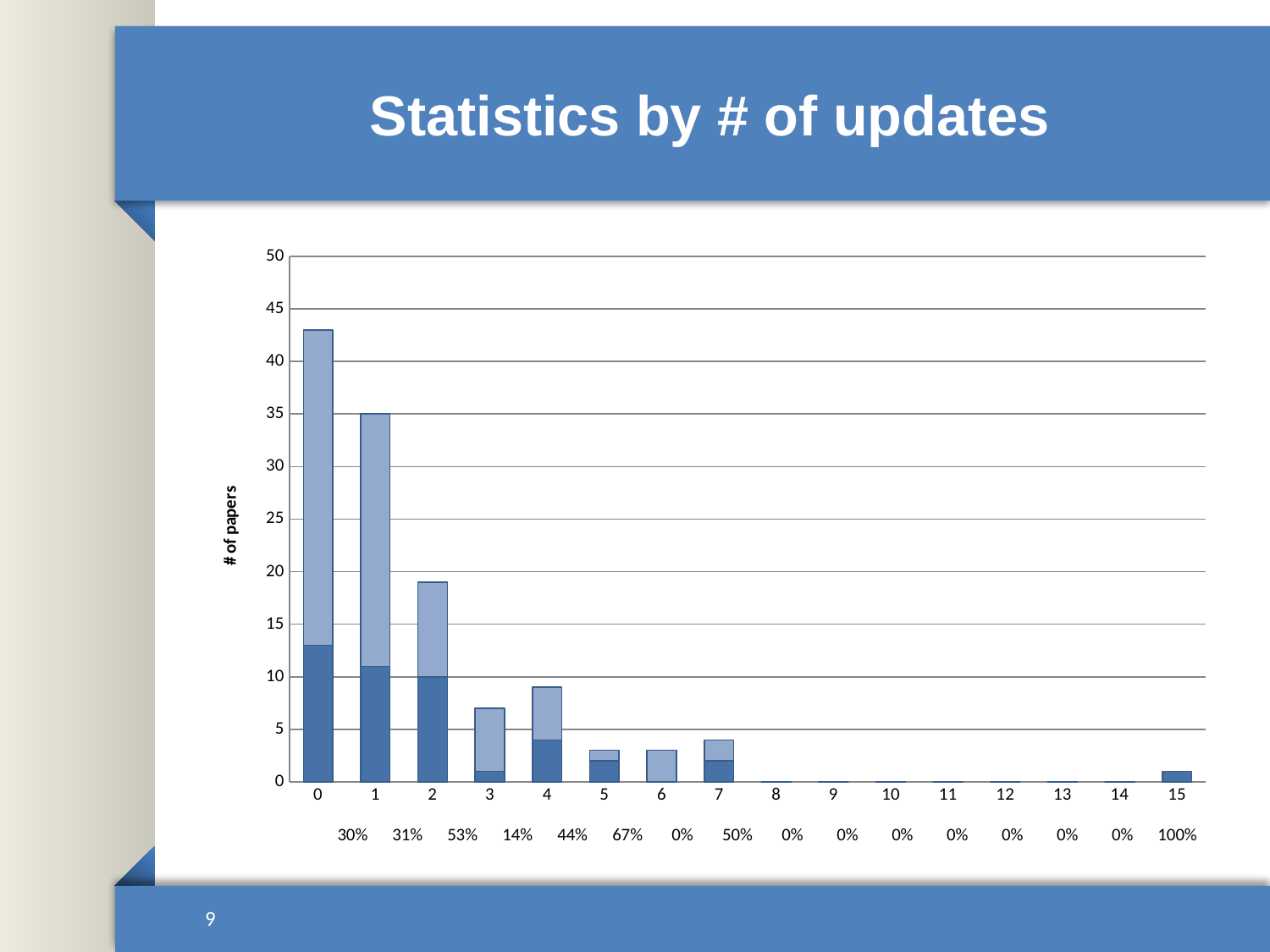
Is the total bar height for category 4 greater or less than 5? greater What percentage is printed below category 15? 100% What is the title of the y axis? # of papers What percentage is printed below category 5? 67% Is the total bar height for category 2 greater or less than 20? less What kind of chart is shown on the slide? bar chart Which has the taller bar, category 1 or category 2? 1 How many categories are shown along the x axis? 16 Which category has the tallest bar? 0 Do the bar heights generally rise or fall from category 0 to category 7? fall Is the total bar height for category 1 greater or less than 30? greater